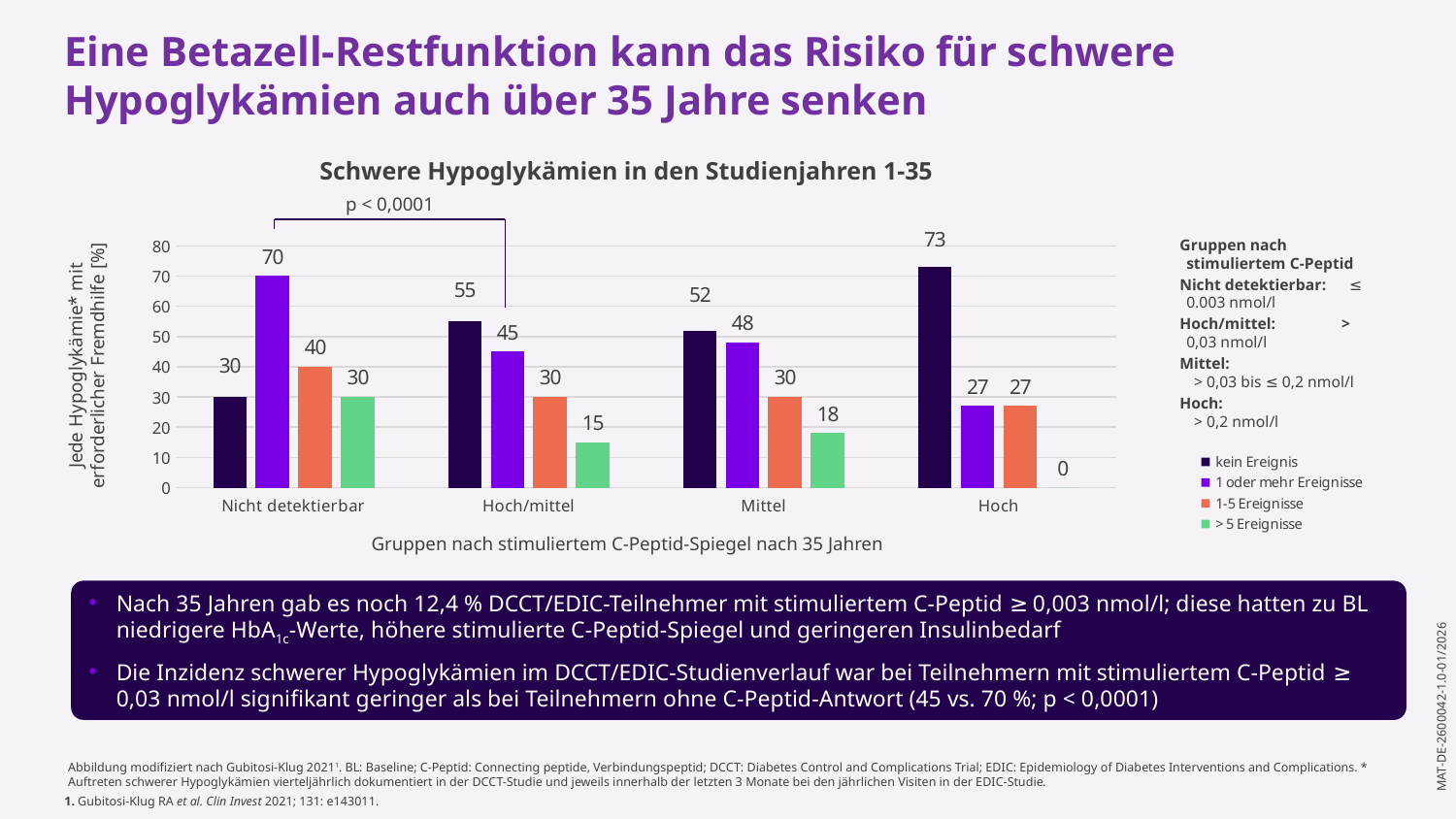
What is the value for 'kein Ereignis' in the 'Hoch' group? 73 Which is larger: 'kein Ereignis' in the 'Mittel' group or '1 oder mehr Ereignisse' in the 'Mittel' group? kein Ereignis What is the title of the chart? Schwere Hypoglykämien in den Studienjahren 1-35 Which group has the lowest value for '> 5 Ereignisse'? Hoch What is the value for '1-5 Ereignisse' in the 'Mittel' group? 30 How many series does the legend list? 4 What type of chart is shown on the slide? bar chart What is the difference between the '1 oder mehr Ereignisse' values for 'Nicht detektierbar' and 'Hoch/mittel'? 25 Which group has the highest value for 'kein Ereignis'? Hoch What is the value for '> 5 Ereignisse' in the 'Hoch/mittel' group? 15 How many C-peptide groups are shown on the x axis? 4 What is the value for '1 oder mehr Ereignisse' in the 'Nicht detektierbar' group? 70